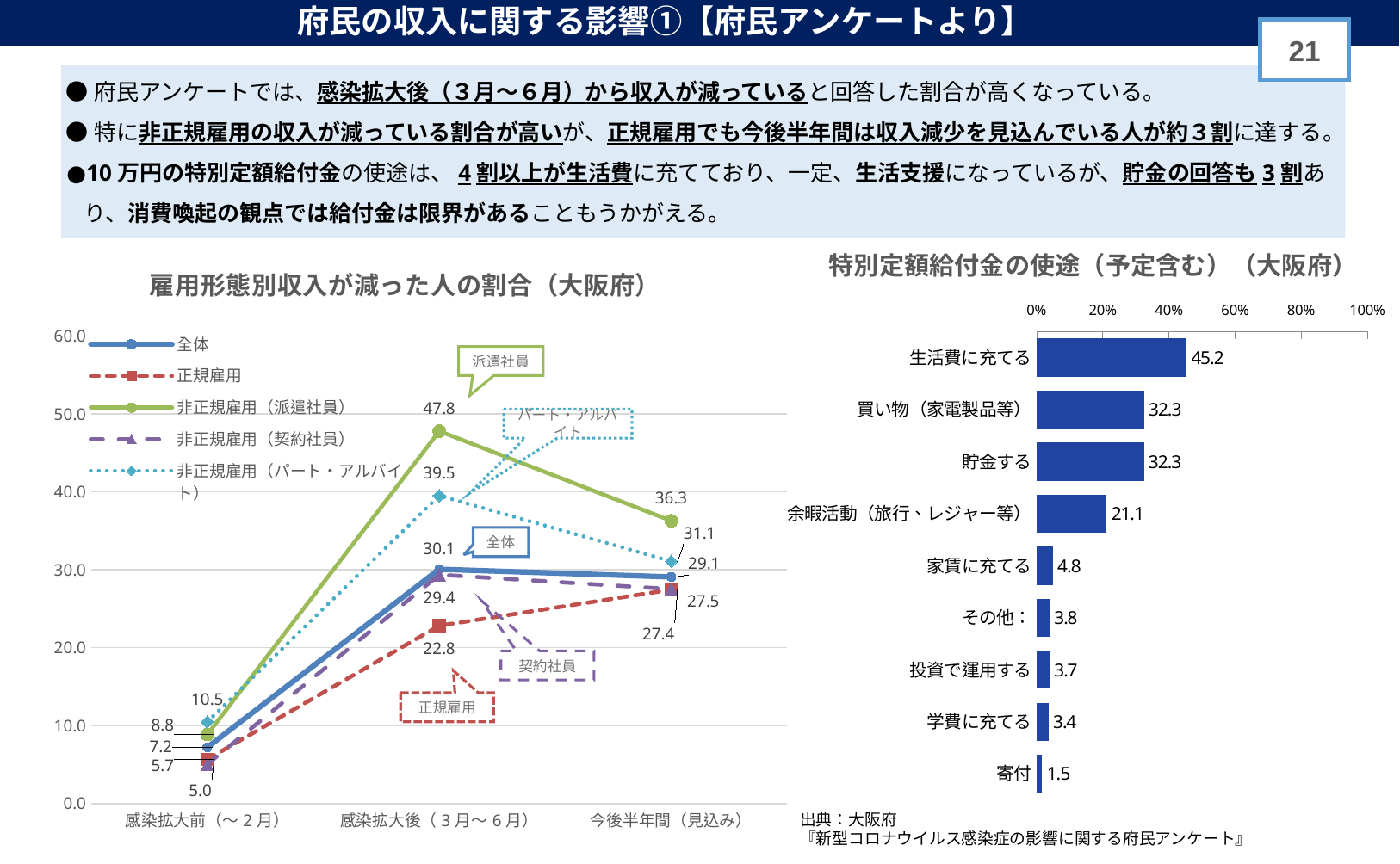
In the chart 雇用形態別収入が減った人の割合（大阪府）, how many series does the legend list? 5 In the chart 雇用形態別収入が減った人の割合（大阪府）, which series has the highest value at 今後半年間（見込み）? 非正規雇用（派遣社員） In the chart 雇用形態別収入が減った人の割合（大阪府）, does the value for 非正規雇用（派遣社員） rise or fall from 感染拡大後（３月～６月） to 今後半年間（見込み）? Fall In the chart 特別定額給付金の使途（予定含む）（大阪府）, which category has the highest value? 生活費に充てる In the chart 特別定額給付金の使途（予定含む）（大阪府）, which category has the lowest value? 寄付 What kind of chart is 特別定額給付金の使途（予定含む）（大阪府）? Bar chart In the chart 雇用形態別収入が減った人の割合（大阪府）, what is the value for 正規雇用 at 感染拡大後（３月～６月）? 22.8 In the chart 特別定額給付金の使途（予定含む）（大阪府）, what is the difference between 生活費に充てる and 貯金する? 12.9 In the chart 特別定額給付金の使途（予定含む）（大阪府）, what is the value for 余暇活動（旅行、レジャー等）? 21.1 In the chart 雇用形態別収入が減った人の割合（大阪府）, what is the value for 非正規雇用（派遣社員） at 感染拡大後（３月～６月）? 47.8 In the chart 特別定額給付金の使途（予定含む）（大阪府）, what is the value for 生活費に充てる? 45.2 In the chart 特別定額給付金の使途（予定含む）（大阪府）, how many categories are shown? 9